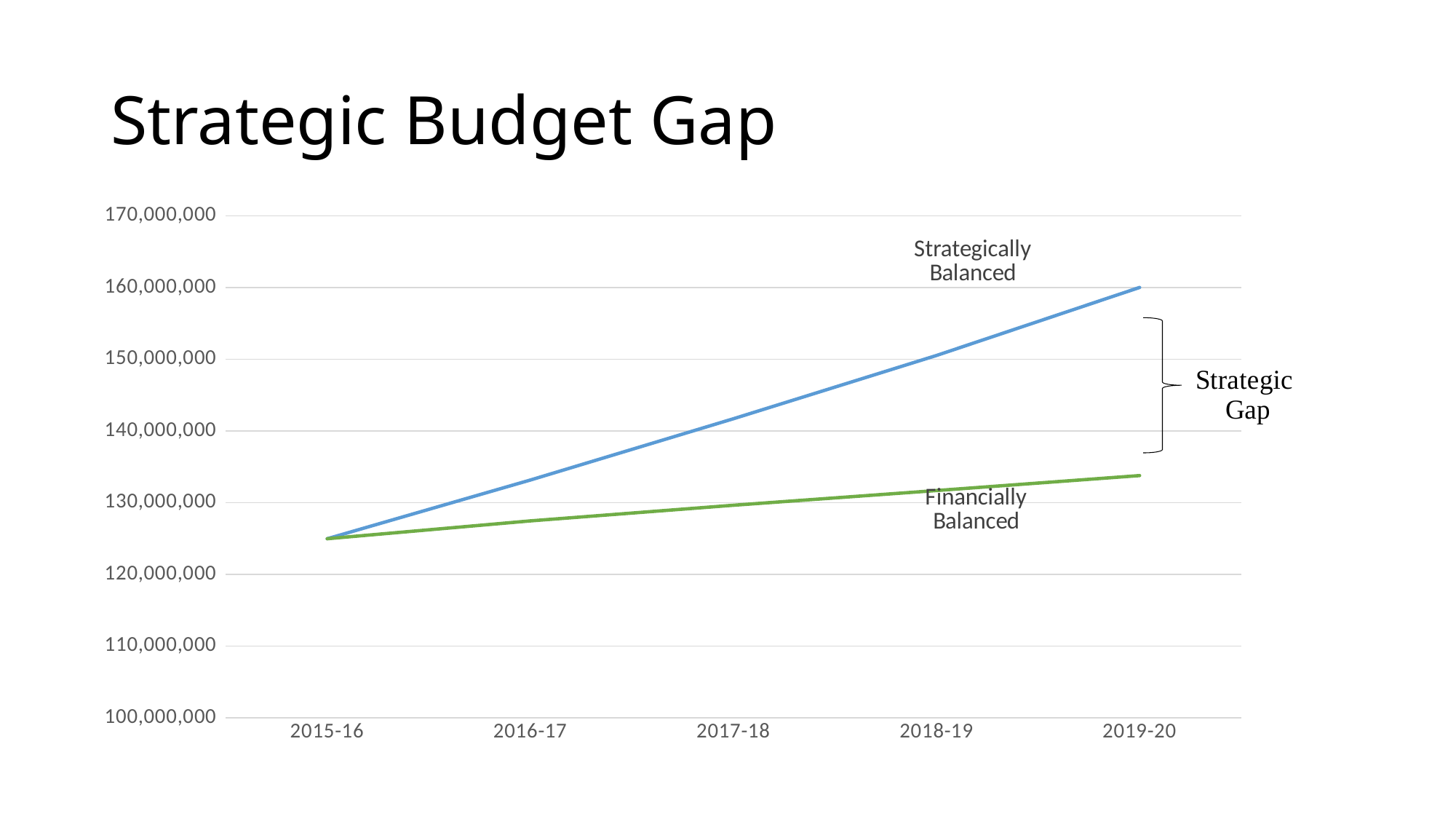
Is the value of the Financially Balanced line in 2019-20 greater or less than 130,000,000? greater What label is attached to the bracket between the two lines on the right side of the chart? Strategic Gap Is the starting value of the lines in 2015-16 greater or less than 120,000,000? greater Does the Strategically Balanced line rise or fall from 2015-16 to 2019-20? rise What is the title of the slide? Strategic Budget Gap What kind of chart is shown on the slide? line chart Is the value of the Financially Balanced line in 2019-20 greater or less than 140,000,000? less Which line is higher in 2019-20, Strategically Balanced or Financially Balanced? Strategically Balanced How many fiscal years are shown on the x axis? 5 How many lines are plotted on the chart? 2